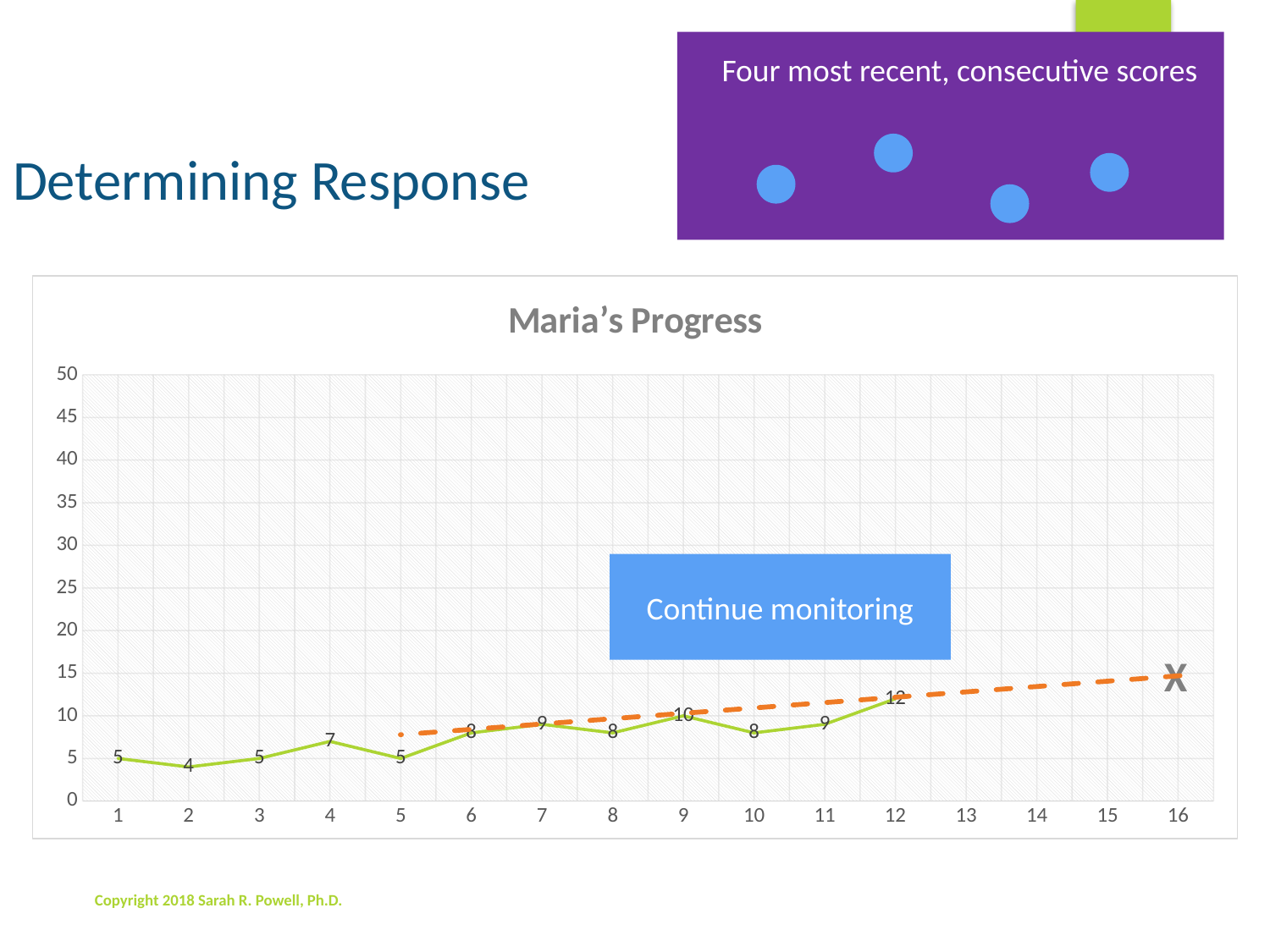
What is Maria's score at point 2? 4 How many data points are plotted on Maria's progress line? 12 At which point is Maria's score highest? 12 Is Maria's score at point 12 greater or less than 10? greater What is Maria's score at point 9? 10 What kind of chart is shown on the slide? line chart Do Maria's scores generally rise or fall from point 1 to point 12? rise Which is larger, Maria's score at point 4 or at point 5? point 4 What is the difference between Maria's score at point 12 and her score at point 1? 7 What is the title of the chart? Maria's Progress What is Maria's score at point 12? 12 At which point is Maria's score lowest? 2